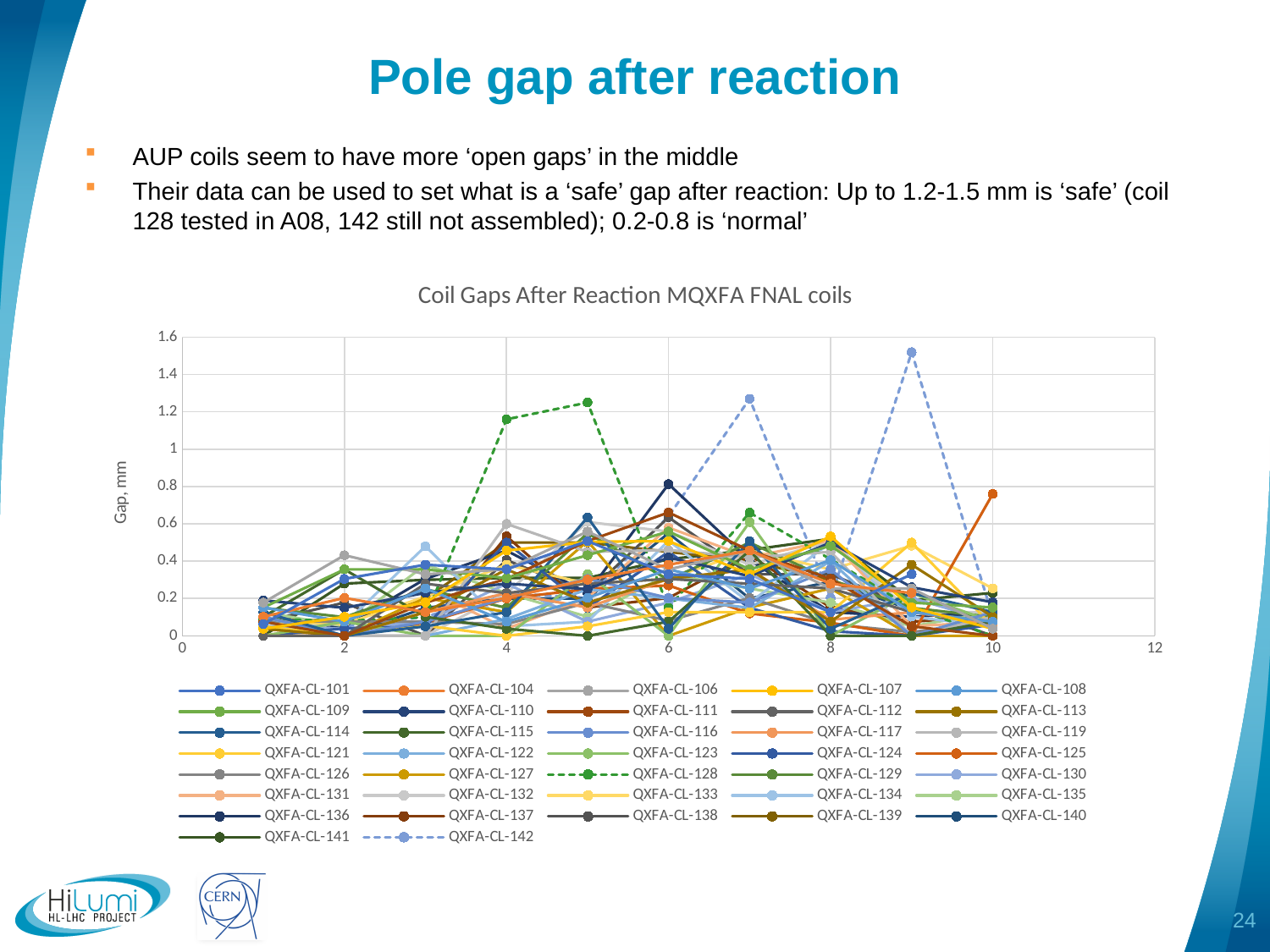
What is the label of the vertical axis of the chart? Gap, mm Is the peak value of QXFA-CL-142 at x = 9 greater or less than 1.4? greater How many series does the chart's legend list? 37 What is the title of the chart? Coil Gaps After Reaction MQXFA FNAL coils Which is larger: the peak of QXFA-CL-142 at x = 9 or the peak of QXFA-CL-128 at x = 5? QXFA-CL-142 at x = 9 What is the maximum value shown on the vertical axis of the chart? 1.6 Is the value of QXFA-CL-142 at x = 10 greater or less than 0.6? less What kind of chart is shown on the slide? Line chart Is the value of QXFA-CL-128 at x = 4 greater or less than 1? greater Which series reaches the highest gap value on the chart? QXFA-CL-142